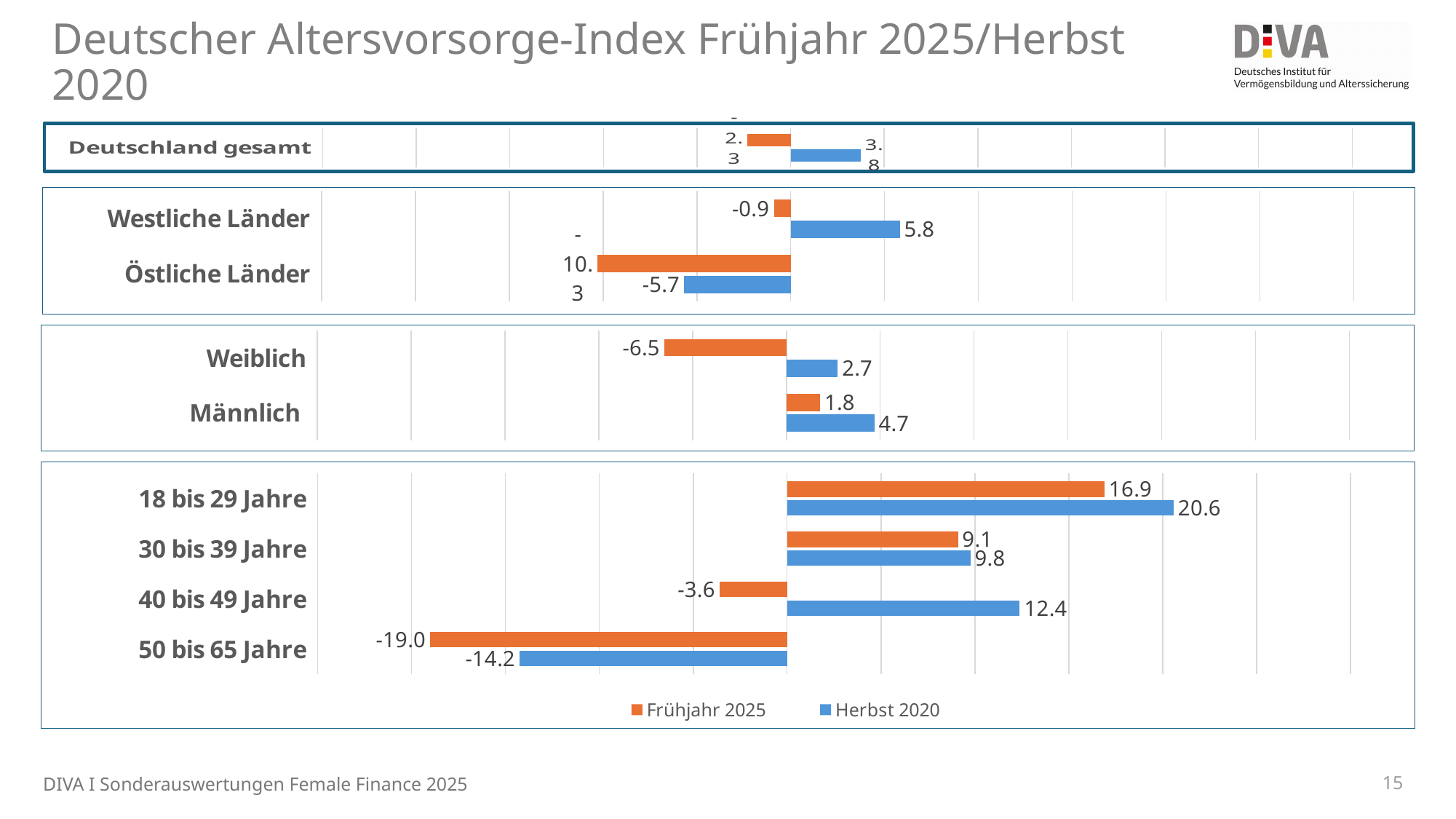
What type of chart is used for the age-group panel at the bottom? Bar chart In the age-group chart at the bottom, what is the Frühjahr 2025 value for 50 bis 65 Jahre? -19.0 In the age-group chart at the bottom, what is the difference between the Herbst 2020 and Frühjahr 2025 values for 40 bis 49 Jahre? 16.0 In the age-group chart at the bottom, which age group has the highest Frühjahr 2025 value? 18 bis 29 Jahre How many age groups are shown in the age-group chart at the bottom? 4 In the gender chart (Weiblich/Männlich), what is the Frühjahr 2025 value for Weiblich? -6.5 In the age-group chart at the bottom, which age group has the lowest Herbst 2020 value? 50 bis 65 Jahre In the age-group chart at the bottom, what is the difference between the Frühjahr 2025 values for 18 bis 29 Jahre and 30 bis 39 Jahre? 7.8 In the gender chart, which is larger: the Herbst 2020 value for Männlich or for Weiblich? Männlich In the age-group chart at the bottom, what is the Herbst 2020 value for 18 bis 29 Jahre? 20.6 In the regional chart (Westliche/Östliche Länder), what is the Herbst 2020 value for Westliche Länder? 5.8 How many series does the legend at the bottom of the slide list? 2